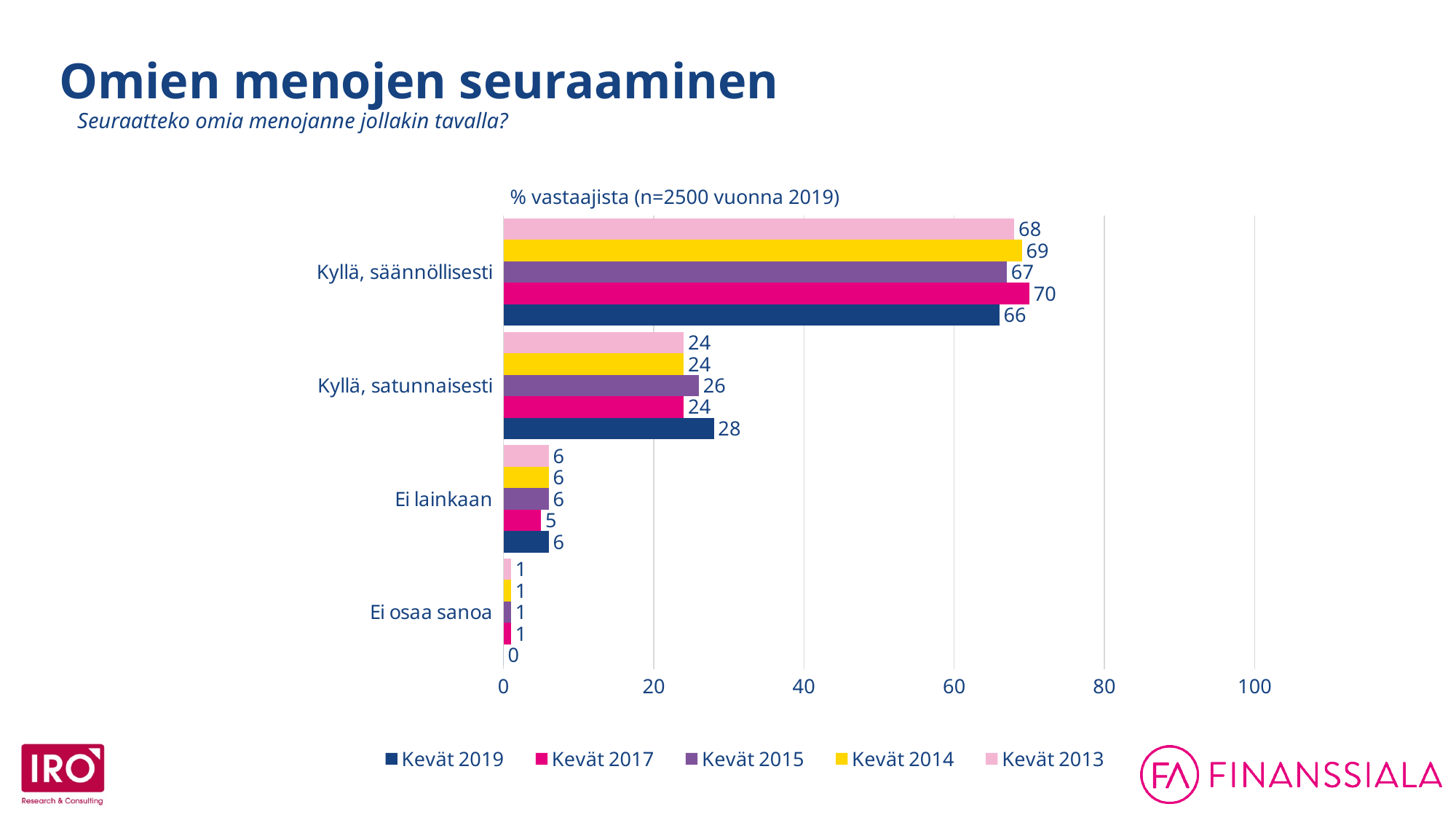
Which series has the highest value in the category 'Kyllä, säännöllisesti'? Kevät 2017 How many response categories are shown on the chart? 4 How many series does the legend list? 5 What is the value for Kevät 2019 in the category 'Kyllä, säännöllisesti'? 66 What is the value for Kevät 2015 in the category 'Kyllä, satunnaisesti'? 26 What is the value for Kevät 2019 in the category 'Ei osaa sanoa'? 0 What kind of chart is shown on the slide? bar chart What is the title shown above the chart? % vastaajista (n=2500 vuonna 2019) Which series has the lowest value in the category 'Ei lainkaan'? Kevät 2017 Which is larger in the category 'Kyllä, säännöllisesti': the value for Kevät 2014 or the value for Kevät 2013? Kevät 2014 What is the difference between the Kevät 2019 and Kevät 2017 values in the category 'Kyllä, satunnaisesti'? 4 What is the value for Kevät 2017 in the category 'Kyllä, säännöllisesti'? 70